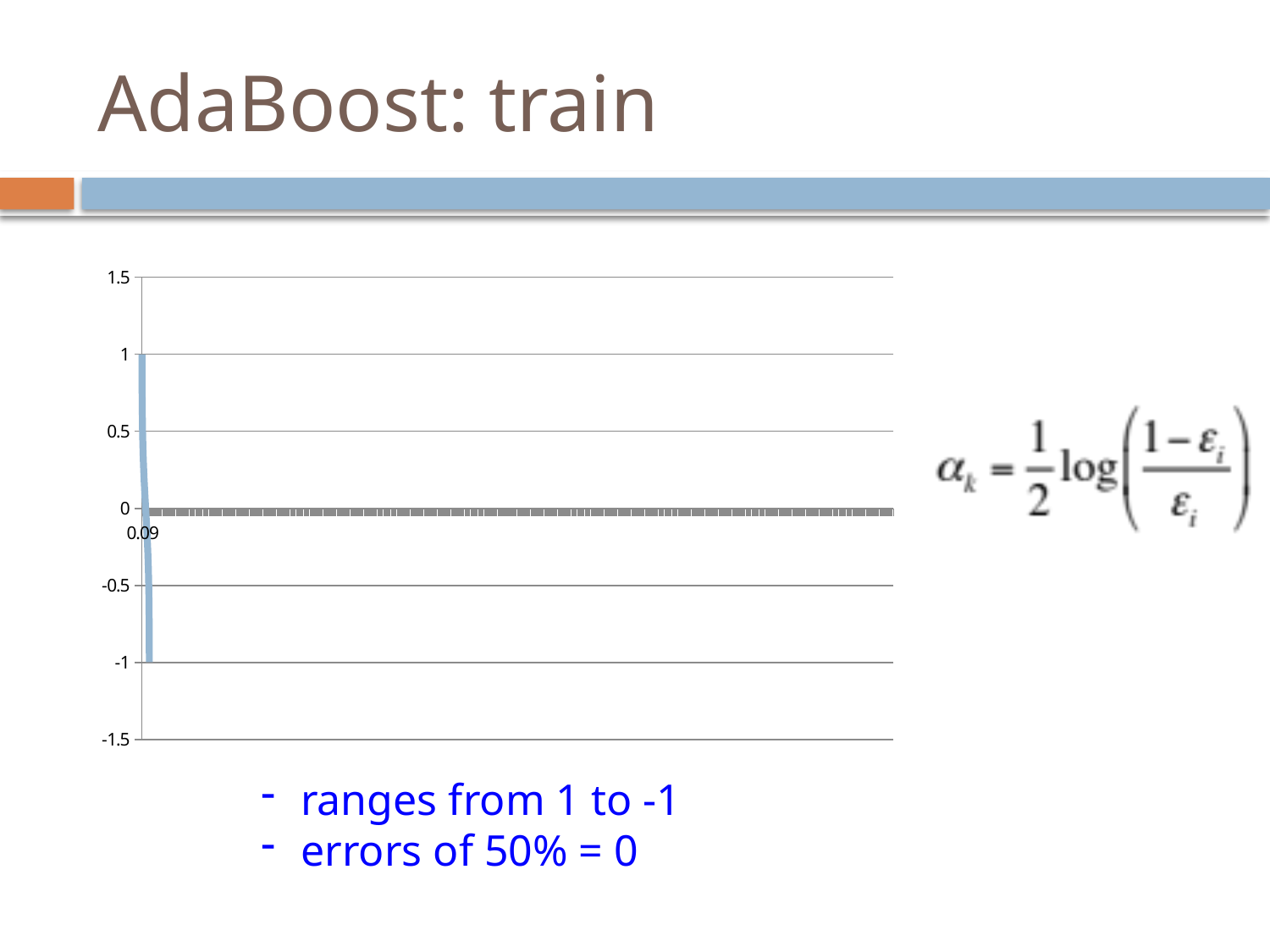
Does the plotted line rise or fall as it moves along the x axis? fall Is the highest point of the plotted line greater or less than 0.5? greater What is the lowest tick value shown on the y axis of the chart? -1.5 Is the lowest point of the plotted line greater or less than -0.5? less What kind of chart is shown on the slide? line chart What is the highest tick value shown on the y axis of the chart? 1.5